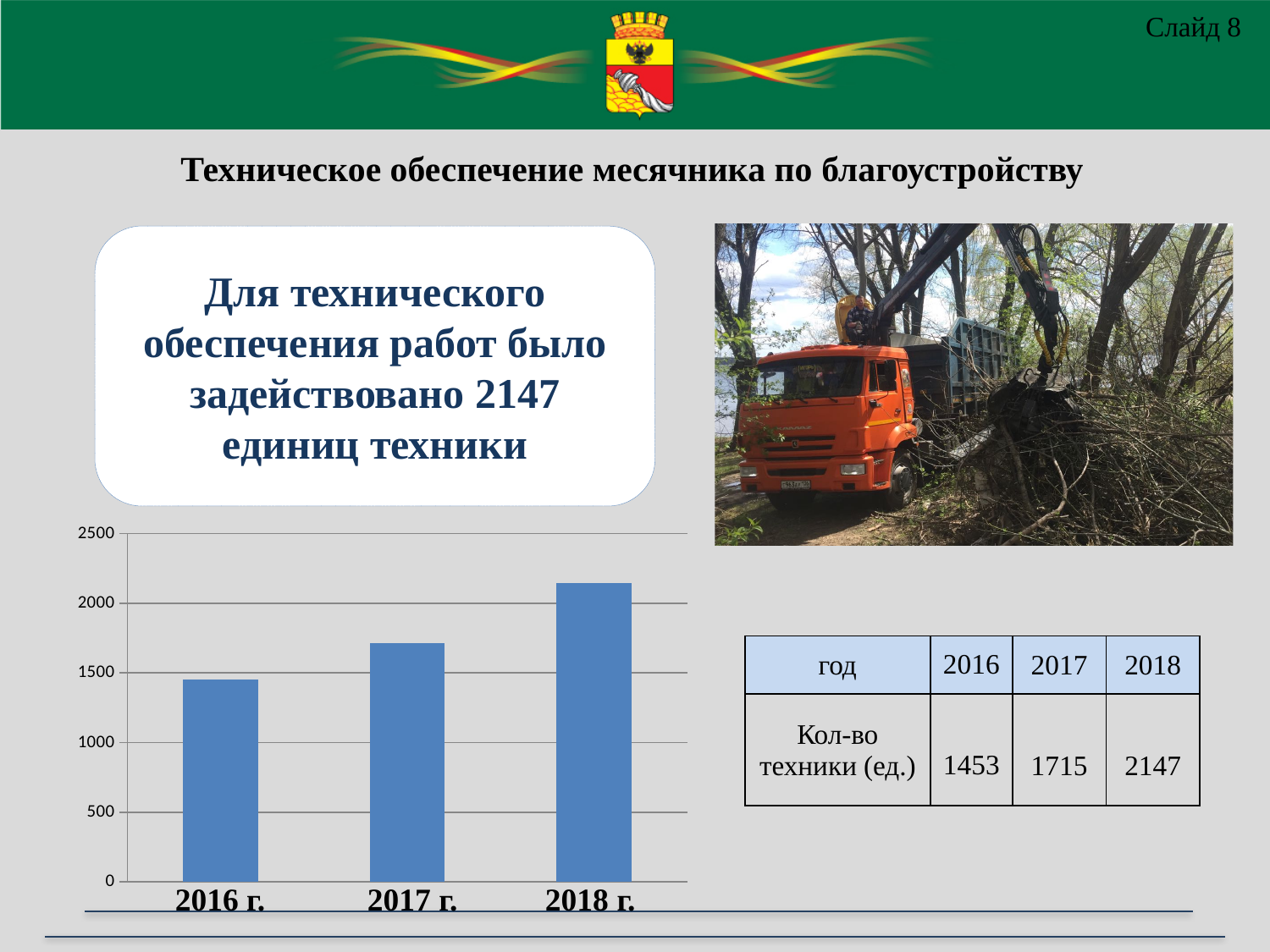
What kind of chart is shown on the slide? bar chart Is the value for 2016 г. greater or less than 1500? less According to the table on the slide, how many units of equipment (Кол-во техники) were used in 2017? 1715 How many bars (years) does the chart show? 3 Is the value for 2018 г. greater or less than 2000? greater What is the highest value shown on the chart's vertical axis? 2500 Which year has the lowest bar in the chart? 2016 г. Which is larger, the bar for 2017 г. or the bar for 2016 г.? 2017 г. According to the table on the slide, by how much did the number of units of equipment increase from 2016 to 2018? 694 Do the values rise or fall from 2016 to 2018 in the chart? rise Is the value for 2017 г. greater or less than 1500? greater Which year has the highest bar in the chart? 2018 г.